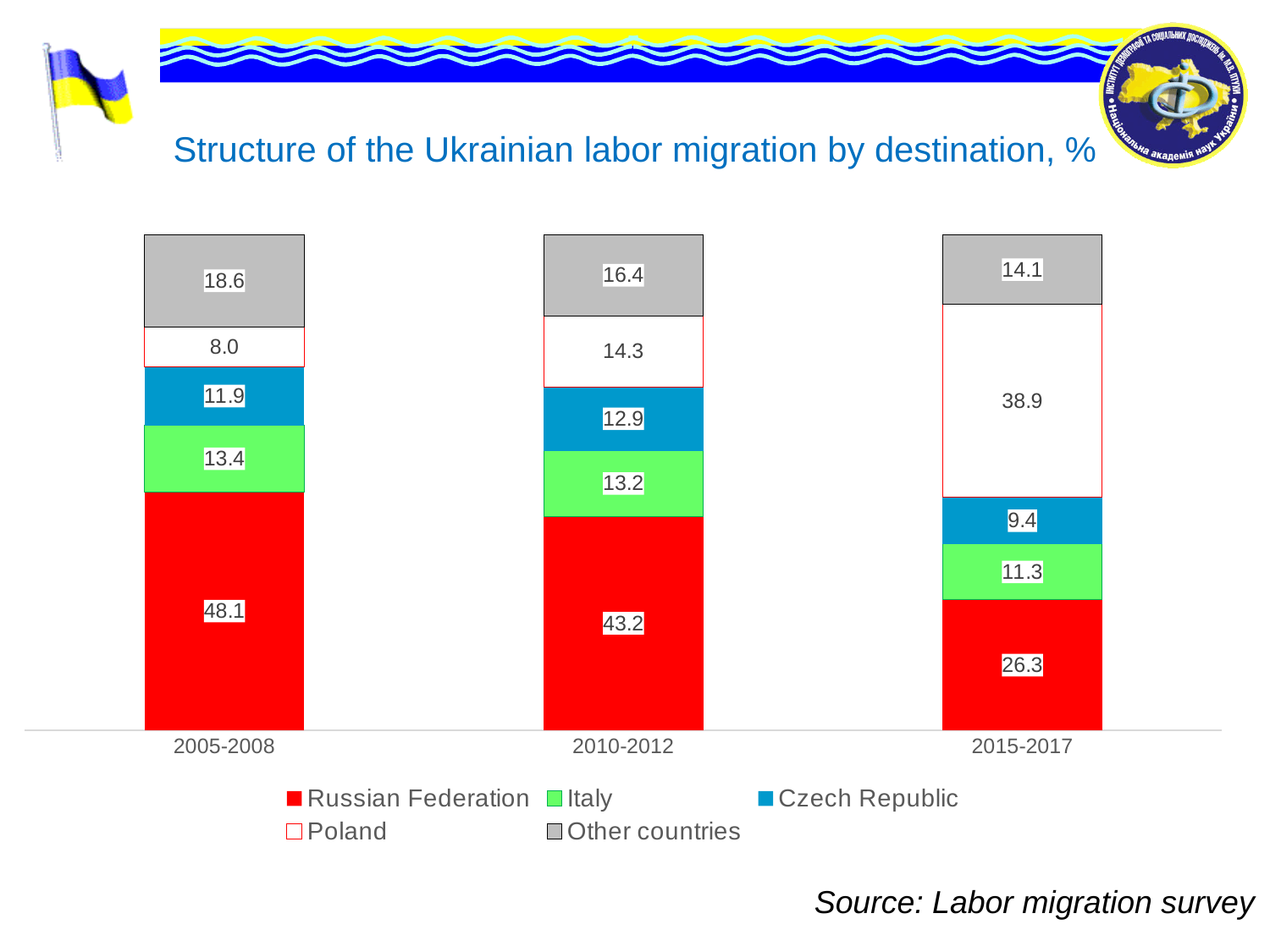
Which destination has the smallest share in 2005-2008? Poland Which destination has the largest share in 2015-2017? Poland What is the value for the Czech Republic in 2010-2012? 12.9 What kind of chart is shown on the slide? Stacked bar chart By how much did the Russian Federation's share fall from 2005-2008 to 2015-2017? 21.8 Which is larger in 2010-2012, the share for Poland or the share for Italy? Poland Does the share for the Russian Federation rise or fall across the three periods? Fall What is the value for Other countries in 2005-2008? 18.6 How many series does the legend list? 5 What is the value for Poland in 2015-2017? 38.9 How many time periods are shown on the x axis? 3 What share of Ukrainian labor migration went to the Russian Federation in 2005-2008? 48.1